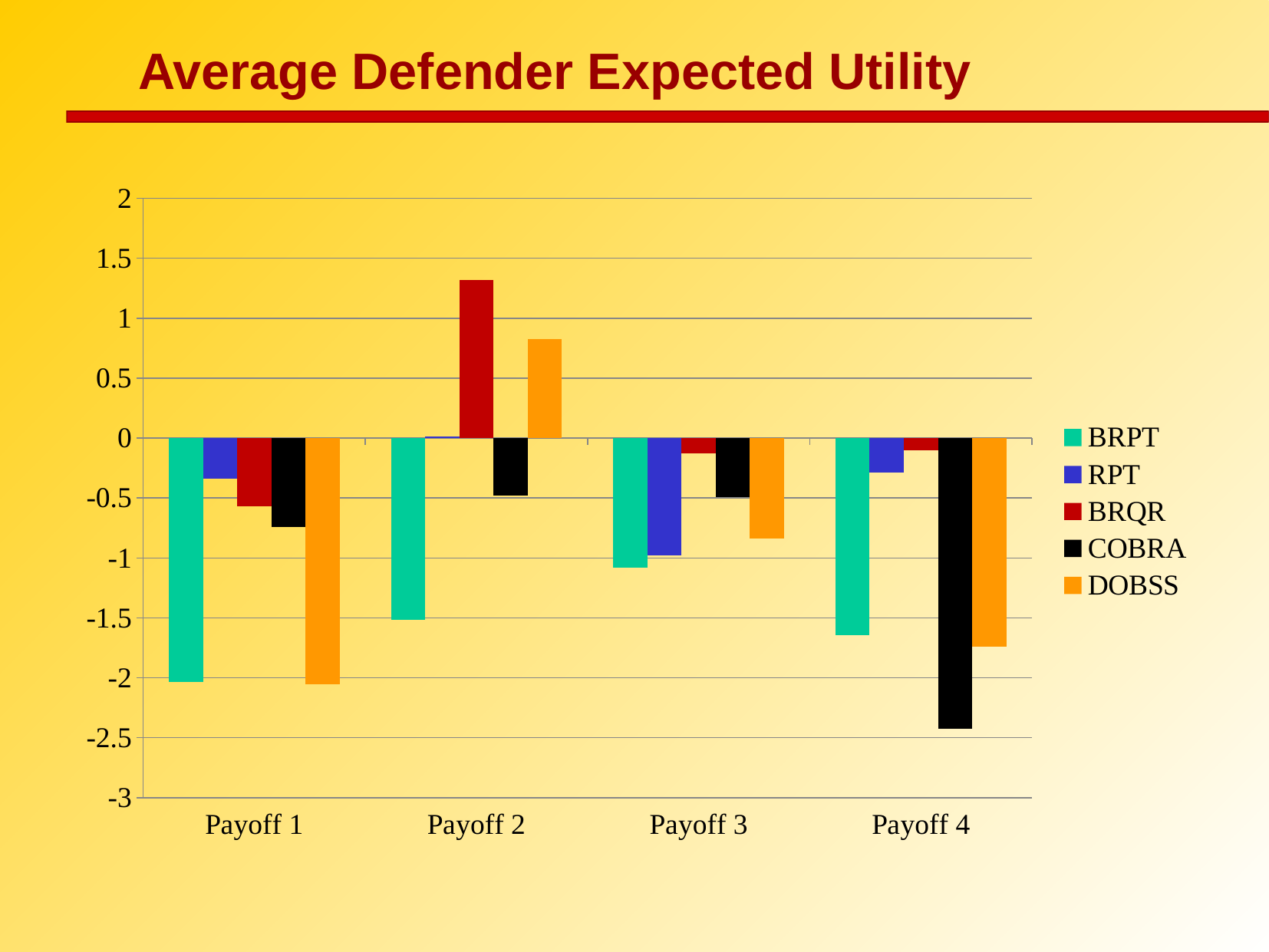
Is the value for BRPT at Payoff 4 greater or less than -1.5? less Which series has the lowest value for Payoff 4? COBRA For Payoff 3, which is larger: the value for BRPT or the value for BRQR? BRQR Is the value for BRQR at Payoff 2 greater or less than 1? greater How many series does the legend list? 5 What kind of chart is shown on the slide? bar chart For Payoff 1, which is larger: the value for RPT or the value for COBRA? RPT Which series has the highest value for Payoff 2? BRQR How many payoff categories are shown on the x axis? 4 What is the title of the chart? Average Defender Expected Utility Is the value for COBRA at Payoff 4 greater or less than -2? less